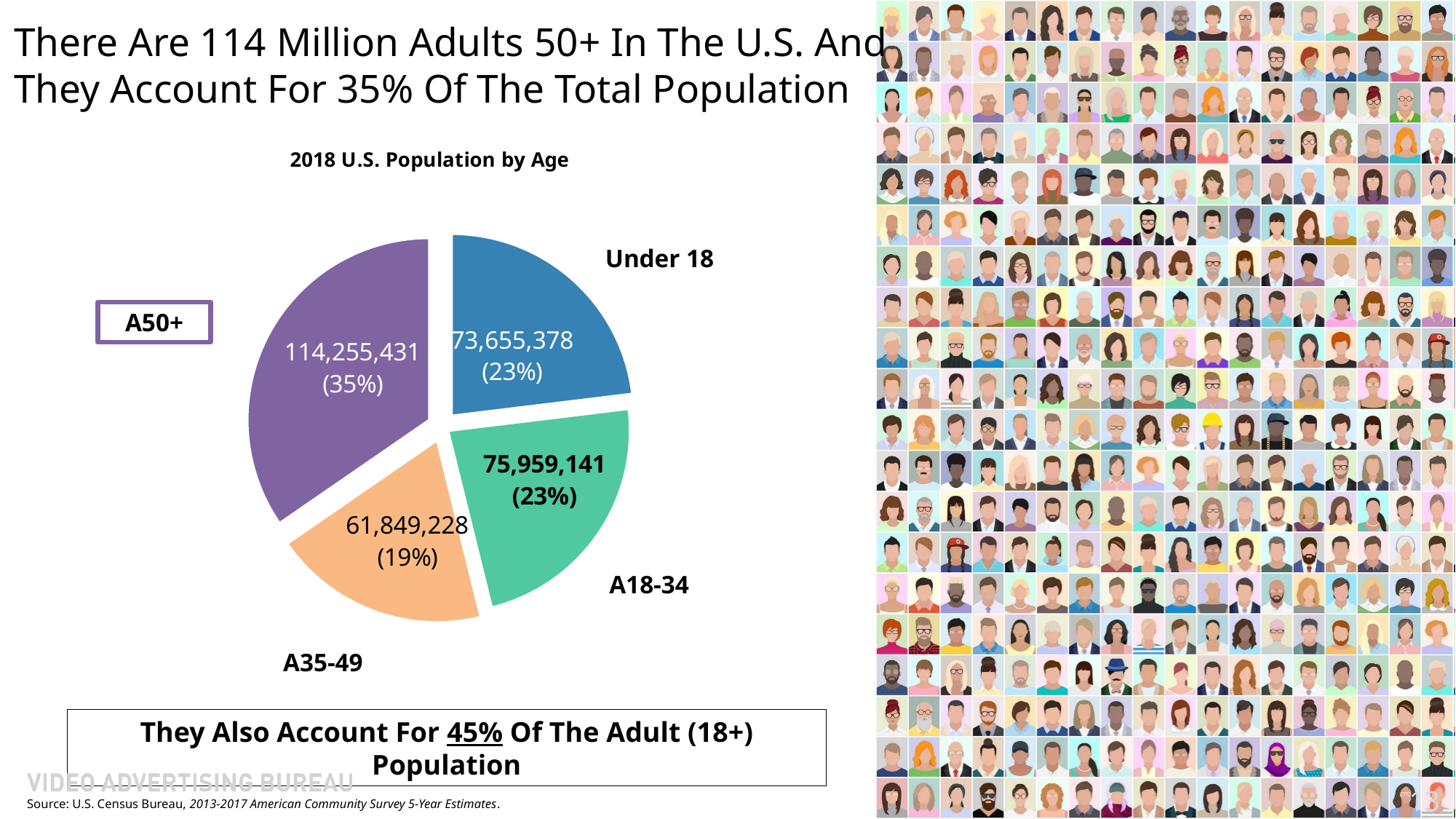
What type of chart is shown on the slide? Pie chart Which age category has the largest share of the pie? A50+ Which has a larger population value, Under 18 or A18-34? A18-34 What is the difference between the A50+ population and the A35-49 population? 52,406,203 What percentage share of the pie does the A35-49 slice represent? 19% What is the title of the chart? 2018 U.S. Population by Age What is the population value shown for the A35-49 slice? 61,849,228 Which age category has the smallest share of the pie? A35-49 What is the population value shown for the Under 18 slice? 73,655,378 What is the population value shown for the A50+ slice? 114,255,431 What is the population value shown for the A18-34 slice? 75,959,141 How many age categories does the pie chart show? 4